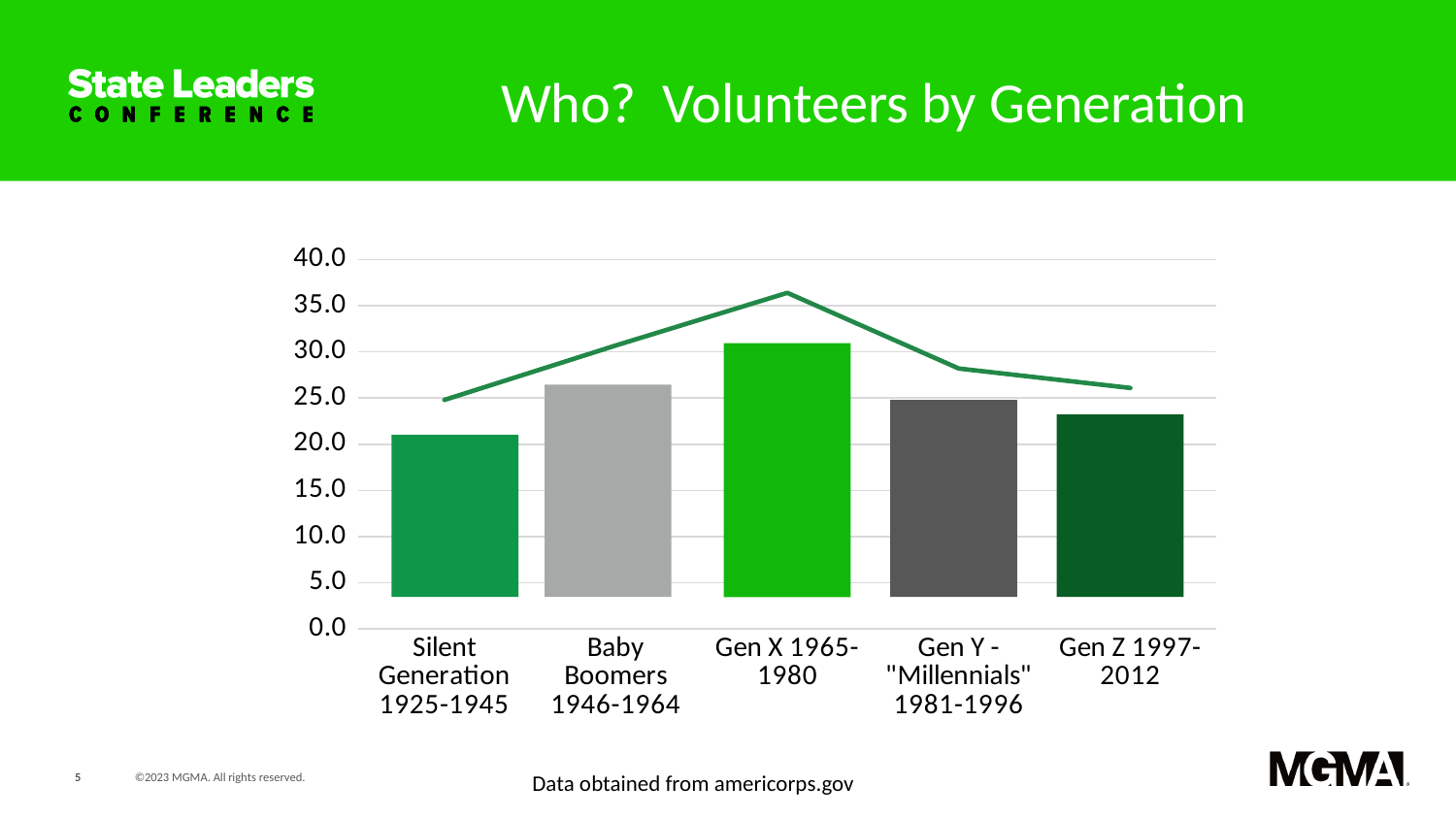
Which generation has the shortest bar? Silent Generation 1925-1945 Which generation has the tallest bar? Gen X 1965-1980 Is the bar value for Silent Generation 1925-1945 greater or less than 25.0? less Is the bar value for Baby Boomers 1946-1964 greater or less than 25.0? greater Is the bar value for Gen Z 1997-2012 greater or less than 25.0? less Which has a taller bar, Baby Boomers 1946-1964 or Gen Z 1997-2012? Baby Boomers 1946-1964 How many generation categories are shown on the x axis? 5 How do the bar values change moving from left to right across the generations? They rise to a peak at Gen X, then fall Which has a taller bar, Gen X 1965-1980 or Silent Generation 1925-1945? Gen X 1965-1980 What kind of chart is shown on the slide? Bar chart (with a line overlay) What is the title of the slide containing the chart? Who? Volunteers by Generation